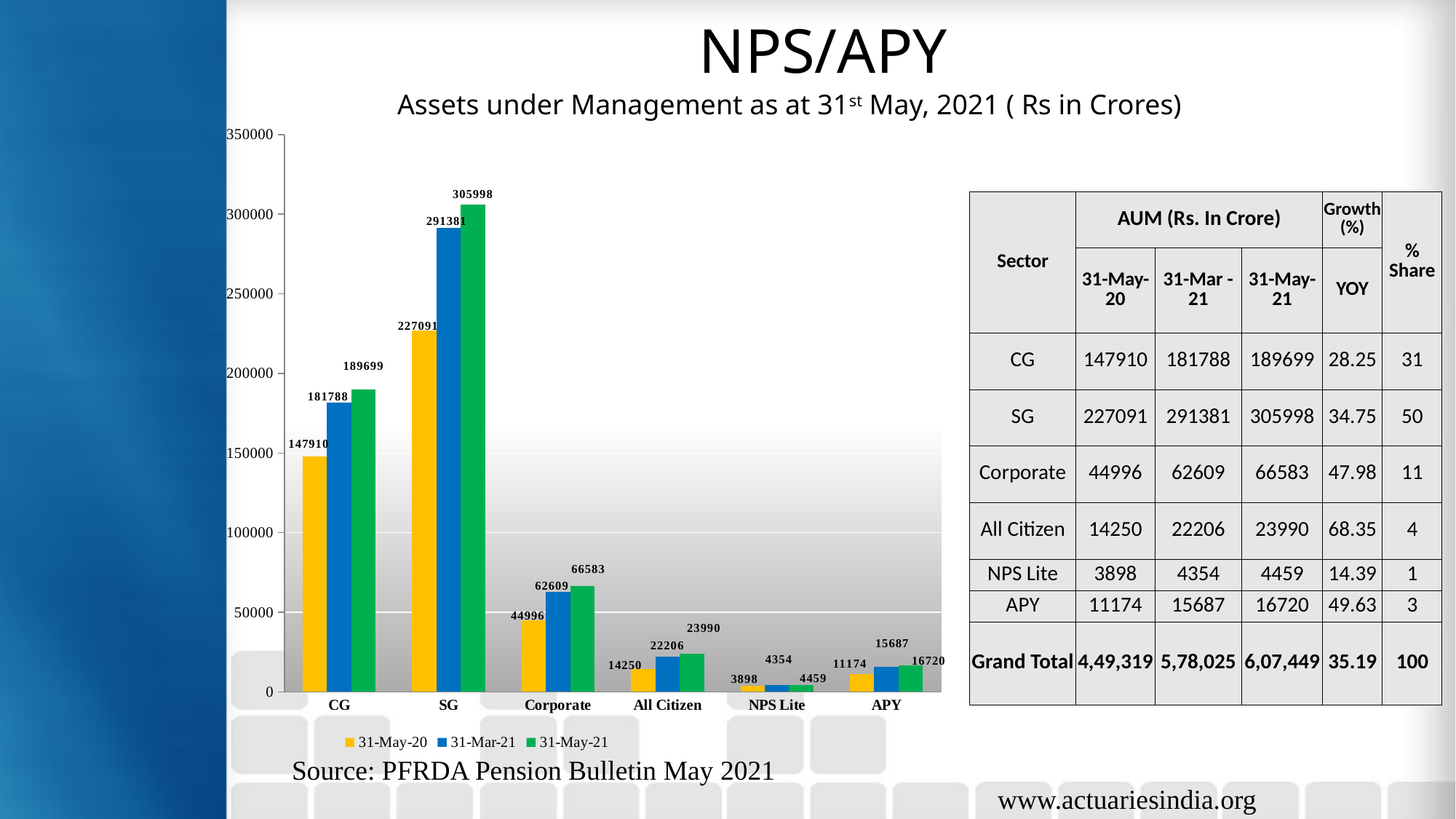
How many series does the chart legend list? 3 What is the value for SG in the 31-May-21 series? 305998 What is the value for All Citizen in the 31-Mar-21 series? 22206 What kind of chart is shown on the slide? bar chart Which is larger: the 31-May-21 value for APY or for All Citizen? All Citizen What is the value for Corporate in the 31-May-20 series? 44996 How many sectors are shown on the x axis of the chart? 6 What is the difference between the 31-May-21 values for SG and CG? 116299 Is the 31-Mar-21 value for CG greater or less than 200000? less By how much did the Corporate value increase from 31-May-20 to 31-May-21? 21587 Which sector has the highest value in the 31-May-21 series? SG Which sector has the lowest value in the 31-May-20 series? NPS Lite